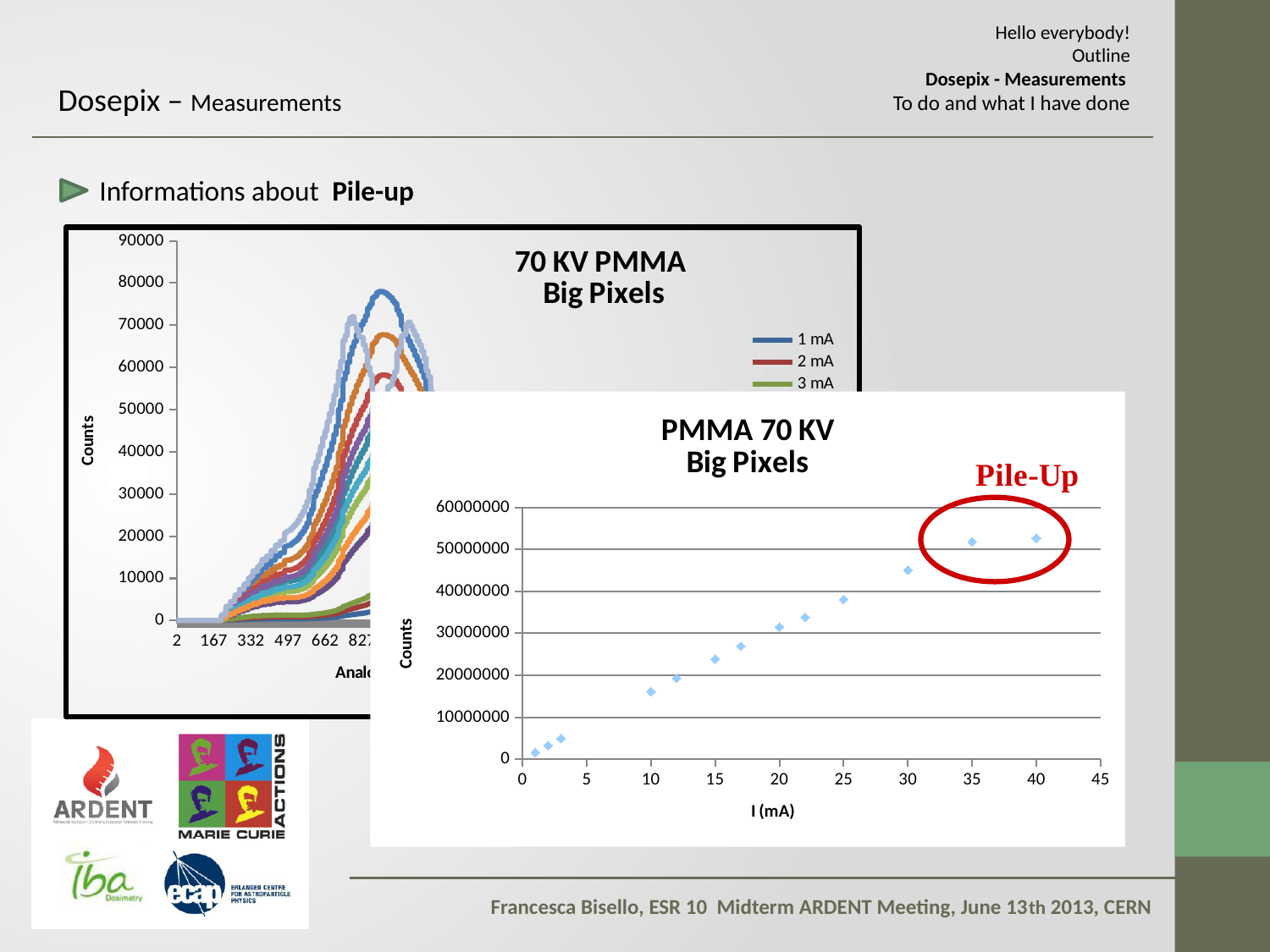
In the 'PMMA 70 KV Big Pixels' chart, do the counts rise or fall as the current increases? rise In the 'PMMA 70 KV Big Pixels' chart, at which current is the count lowest? 1 mA In the 'PMMA 70 KV Big Pixels' chart, is the value at 10 mA greater or less than 10000000? greater In the 'PMMA 70 KV Big Pixels' chart, which has the larger count: 40 mA or 10 mA? 40 mA In the 'PMMA 70 KV Big Pixels' chart, what is the highest value shown on the y axis? 60000000 What type of chart is the '70 KV PMMA Big Pixels' chart? line chart What type of chart is the 'PMMA 70 KV Big Pixels' chart? scatter chart In the 'PMMA 70 KV Big Pixels' chart, what is the label of the x axis? I (mA) In the 'PMMA 70 KV Big Pixels' chart, is the value at 25 mA greater or less than 40000000? less In the '70 KV PMMA Big Pixels' chart, what is the highest value shown on the y axis? 90000 In the 'PMMA 70 KV Big Pixels' chart, is the value at 30 mA greater or less than 40000000? greater